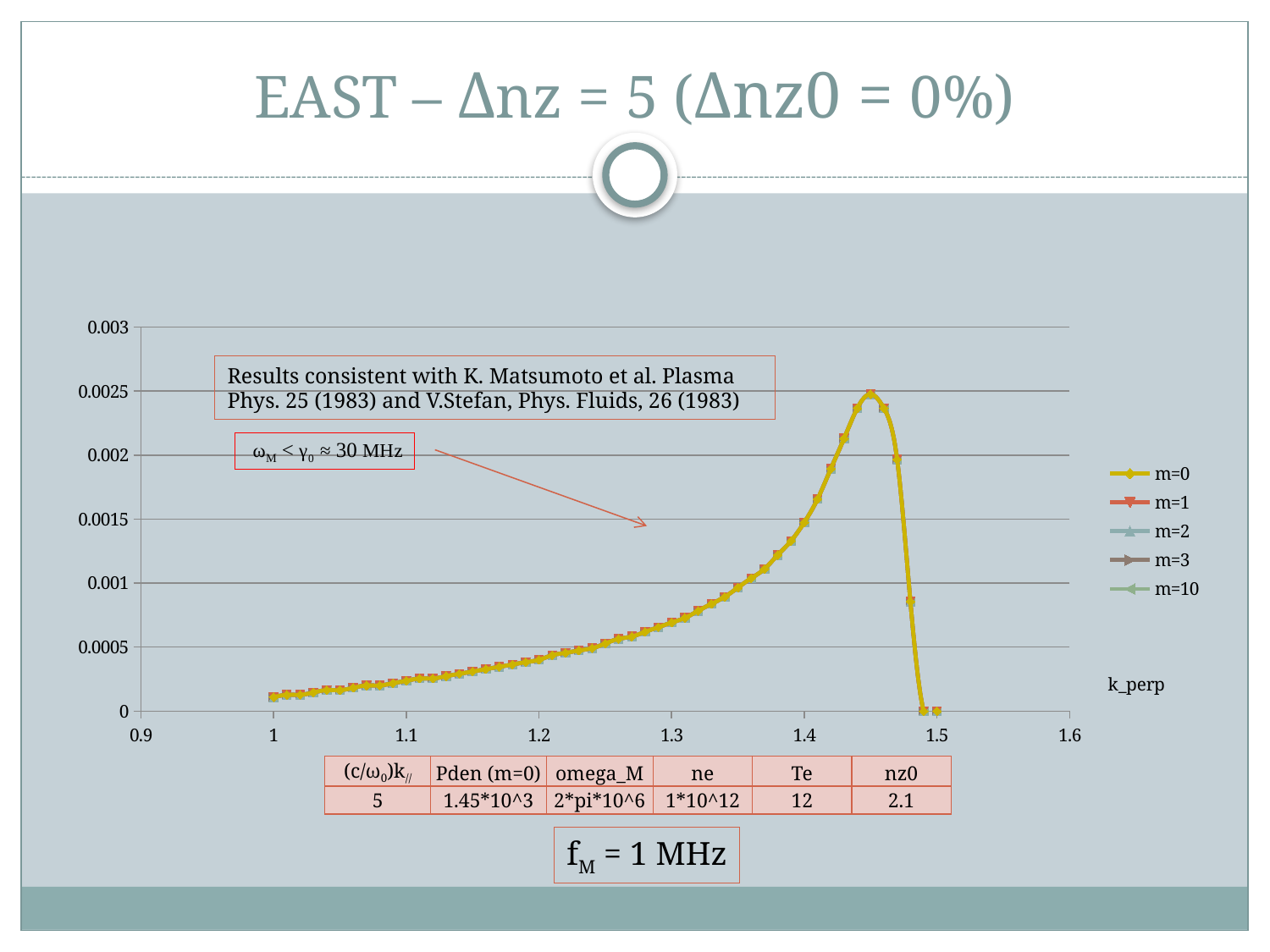
Is the value of the curves at k_perp = 1.0 greater or less than 0.0005? less What kind of chart is shown on the slide? line chart What is the highest tick value shown on the y axis? 0.003 What are the series names listed in the legend? m=0, m=1, m=2, m=3, m=10 How many series does the legend list? 5 Do the plotted values rise or fall as k_perp increases from 1.0 to 1.4? rise What label is shown for the x axis of the chart? k_perp Do the plotted values rise or fall as k_perp increases from 1.45 to 1.5? fall Is the value of the curves at k_perp = 1.4 greater or less than 0.001? greater Is the value of the curves at k_perp = 1.45 greater or less than 0.002? greater